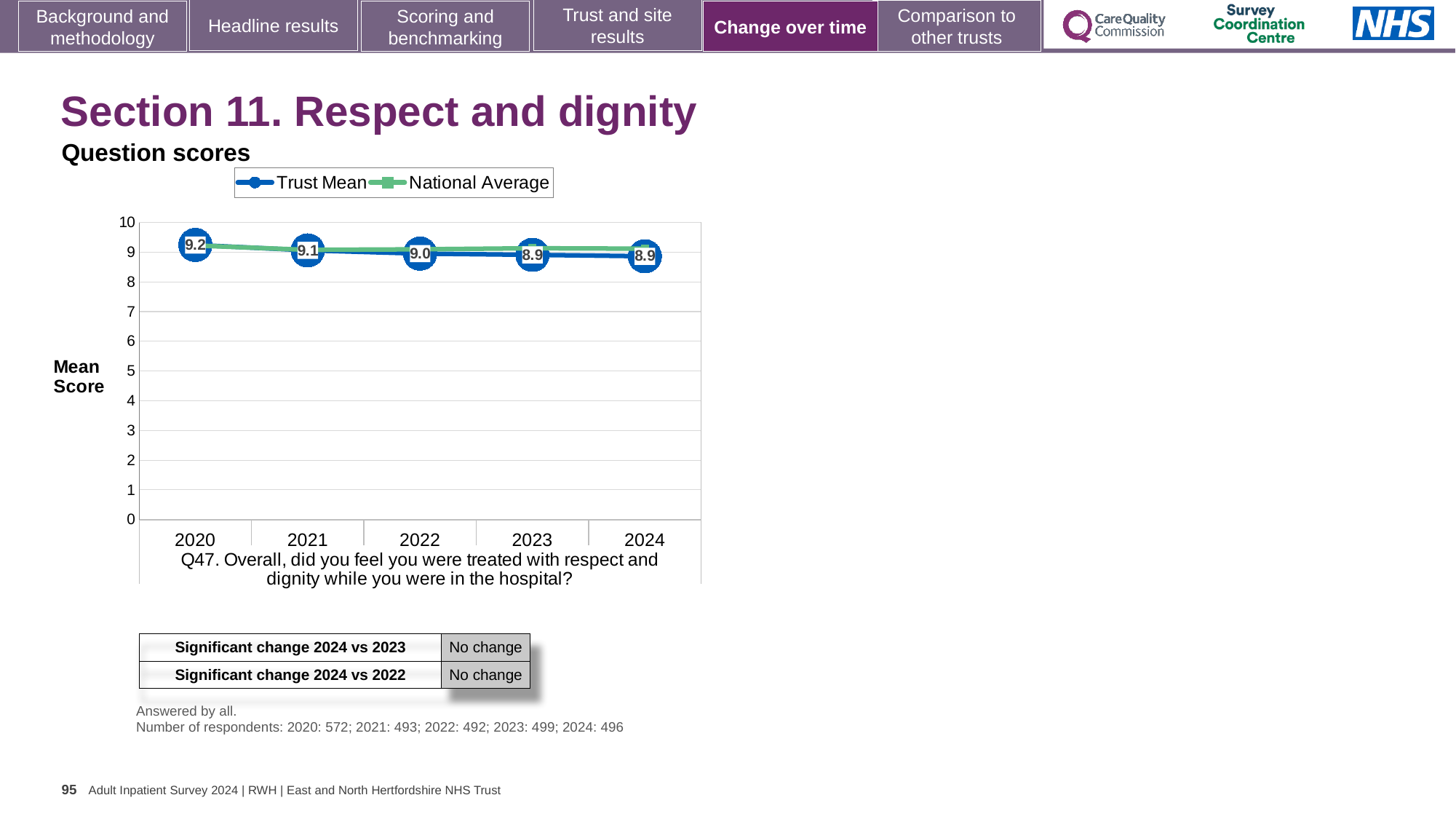
Does the Trust Mean score rise or fall from 2020 to 2024? Fall Is the National Average value for 2024 greater or less than 8? greater What kind of chart is shown on the slide? Line chart How many series does the chart legend list? 2 What is the Trust Mean score for 2020? 9.2 How many years are shown on the x axis of the chart? 5 What is the Trust Mean score for 2024? 8.9 What is the Trust Mean score for 2022? 9.0 What is the label on the y axis of the chart? Mean Score Which is larger, the Trust Mean score in 2021 or in 2023? 2021 What is the difference between the Trust Mean score in 2020 and in 2024? 0.3 In which year is the Trust Mean score highest? 2020